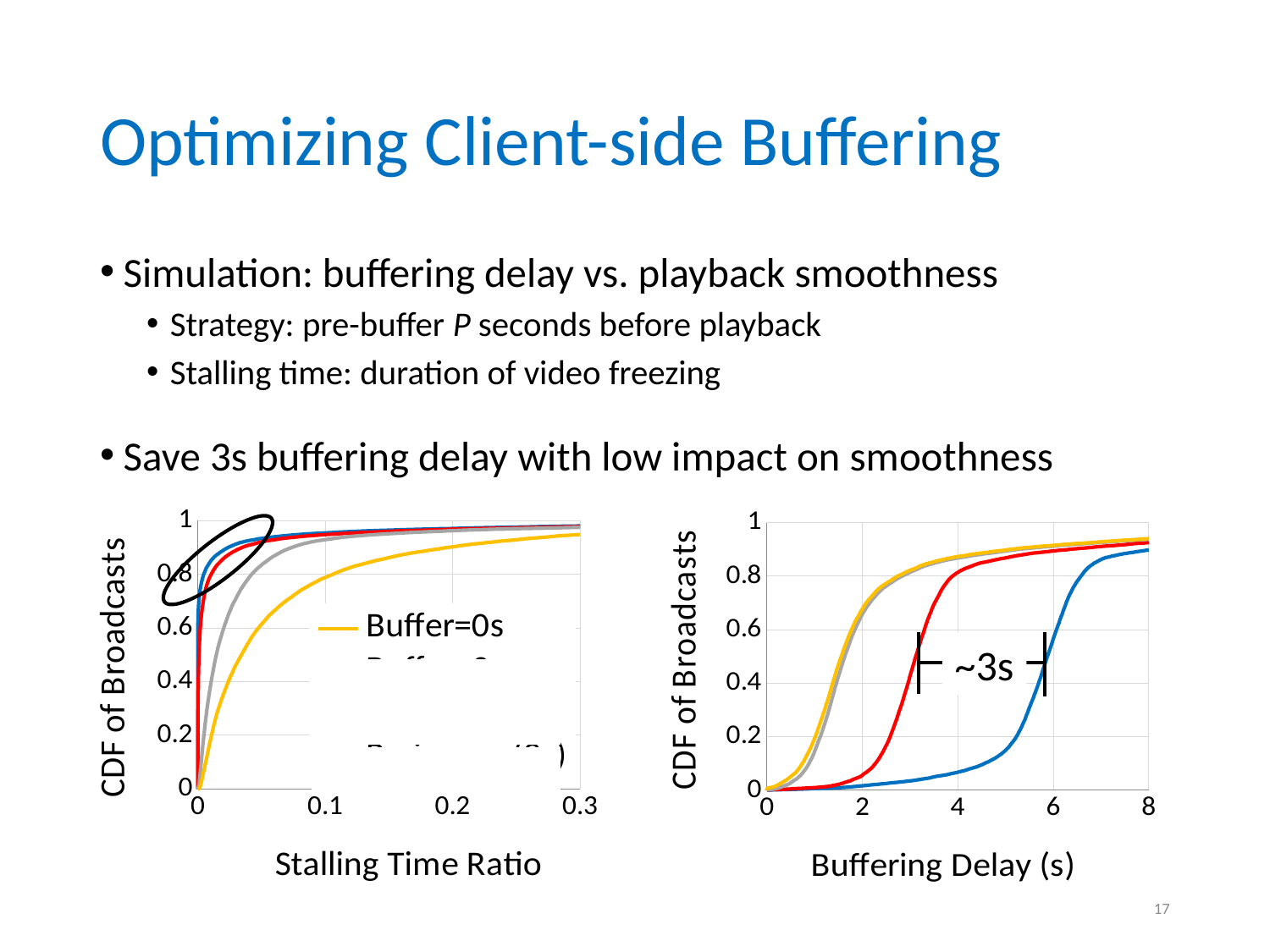
What is the largest value shown on the x-axis of the right chart? 8 In the right chart, at a buffering delay of 2 s, which line has the higher value, the yellow line or the blue line? yellow line In the right chart, what time difference is annotated between the red and blue curves? ~3s In the right chart, at a buffering delay of 4 s, which line has the higher value, the red line or the blue line? red line What kind of chart is the left chart on the slide? line chart In the left chart, do the curves rise or fall as the stalling time ratio increases? rise How many lines are plotted in the right chart? 4 In the right chart, at a buffering delay of 4 s, is the value of the blue line greater or less than 0.2? less What is the y-axis label of the left chart? CDF of Broadcasts In the left chart, at a stalling time ratio of 0.2, is the value of the yellow Buffer=0s line greater or less than 0.8? greater What is the x-axis label of the right chart? Buffering Delay (s) In the right chart, at a buffering delay of 6 s, is the value of the yellow line greater or less than 0.8? greater